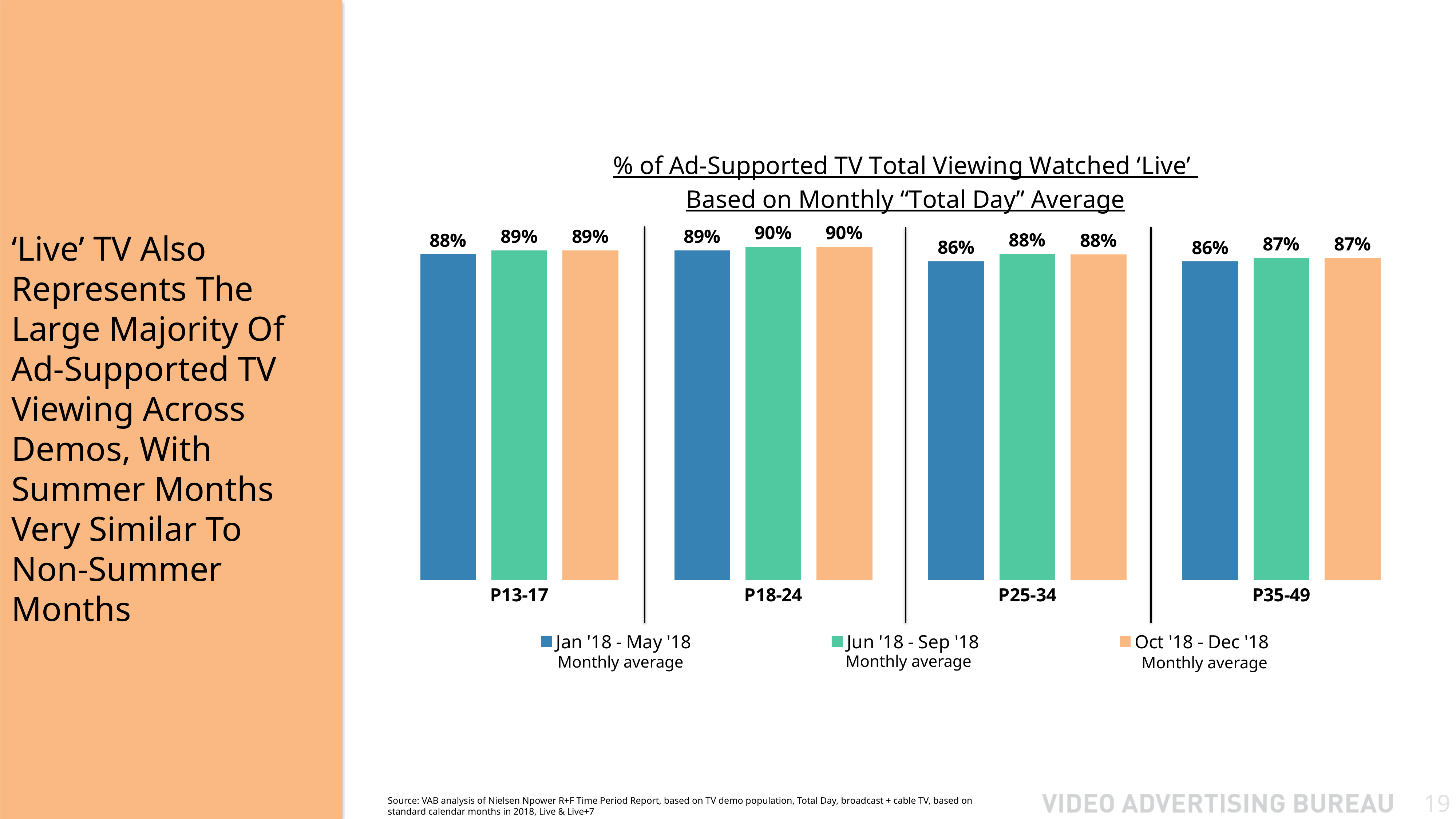
Which demo has the highest value in the Jun '18 - Sep '18 series? P18-24 What is the value for P13-17 in the Jan '18 - May '18 series? 88% How many series does the legend list? 3 What is the difference between the Jun '18 - Sep '18 value and the Jan '18 - May '18 value for P25-34? 2% Which demo has the lowest value in the Oct '18 - Dec '18 series? P35-49 Which is larger for P18-24: the Jan '18 - May '18 value or the Oct '18 - Dec '18 value? Oct '18 - Dec '18 What kind of chart is shown on the slide? Bar chart What is the value for P18-24 in the Jun '18 - Sep '18 series? 90% Which colour represents the Oct '18 - Dec '18 Monthly average series? Orange What is the value for P35-49 in the Jan '18 - May '18 series? 86% How many demo categories are shown on the x axis? 4 What is the value for P25-34 in the Oct '18 - Dec '18 series? 88%